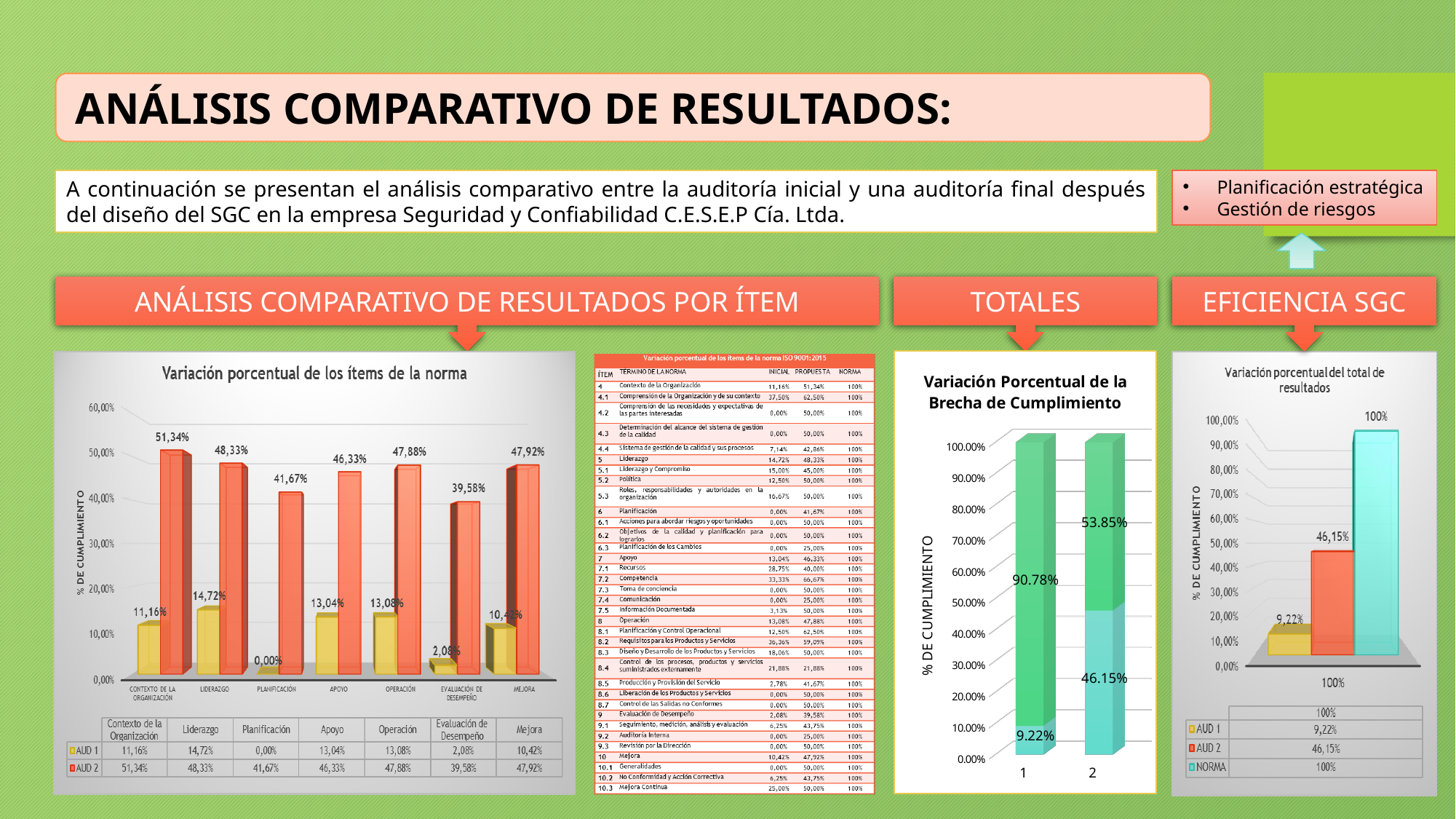
In the chart 'Variación Porcentual de la Brecha de Cumplimiento', what is the total of stacked bar 1? 100.00% In the chart 'Variación porcentual de los ítems de la norma', what is the AUD 2 value for Liderazgo? 48,33% In the chart 'Variación porcentual de los ítems de la norma', is the AUD 1 value for Liderazgo greater or less than 20,00%? less In the chart 'Variación porcentual de los ítems de la norma', which category has the lowest AUD 1 value? Planificación In the chart 'Variación porcentual del total de resultados', what is the value for AUD 2? 46,15% What kind of chart is 'Variación porcentual del total de resultados'? bar chart In the chart 'Variación Porcentual de la Brecha de Cumplimiento', what is the lower segment value of bar 2? 46.15% In the chart 'Variación porcentual de los ítems de la norma', what is the AUD 1 value for Apoyo? 13,04% In the chart 'Variación porcentual de los ítems de la norma', what is the difference between the AUD 2 and AUD 1 values for Mejora? 37,50% In the chart 'Variación porcentual de los ítems de la norma', how many series does the legend list? 2 In the chart 'Variación porcentual de los ítems de la norma', how many categories are shown on the x axis? 7 In the chart 'Variación porcentual de los ítems de la norma', which category has the highest AUD 2 value? Contexto de la Organización